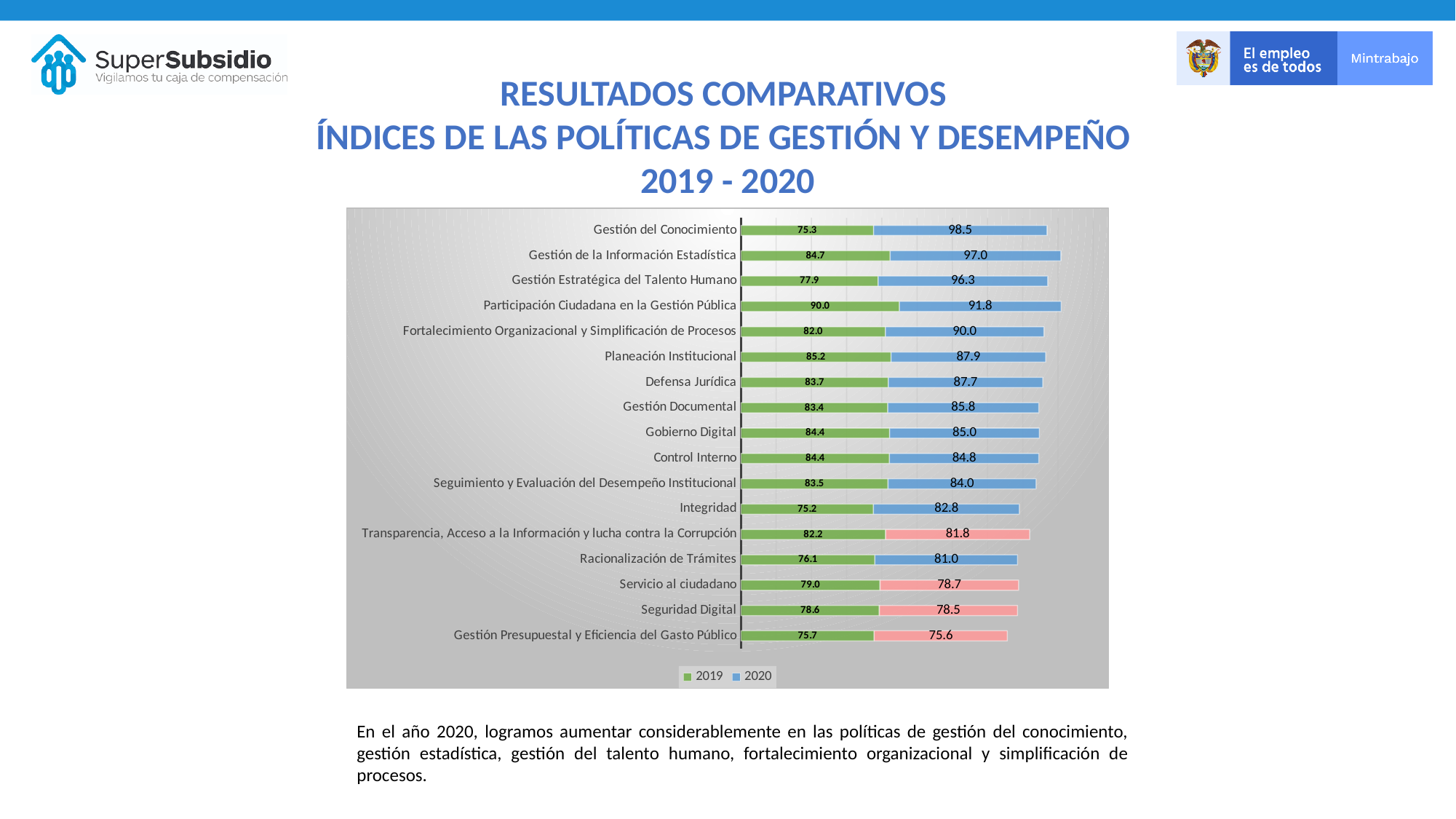
For Transparencia, Acceso a la Información y lucha contra la Corrupción, which year has the larger value, 2019 or 2020? 2019 Which policy has the lowest 2019 value? Integridad What is the 2020 value for Gestión del Conocimiento? 98.5 What is the difference between the 2020 and 2019 values for Gestión del Conocimiento? 23.2 How many policies (categories) are shown in the chart? 17 What kind of chart is shown on the slide? Bar chart Which policy has the lowest 2020 value? Gestión Presupuestal y Eficiencia del Gasto Público What is the 2019 value for Participación Ciudadana en la Gestión Pública? 90.0 How many series does the legend list? 2 Which policy has the highest 2019 value? Participación Ciudadana en la Gestión Pública What is the 2020 value for Racionalización de Trámites? 81.0 Which policy has the highest 2020 value? Gestión del Conocimiento